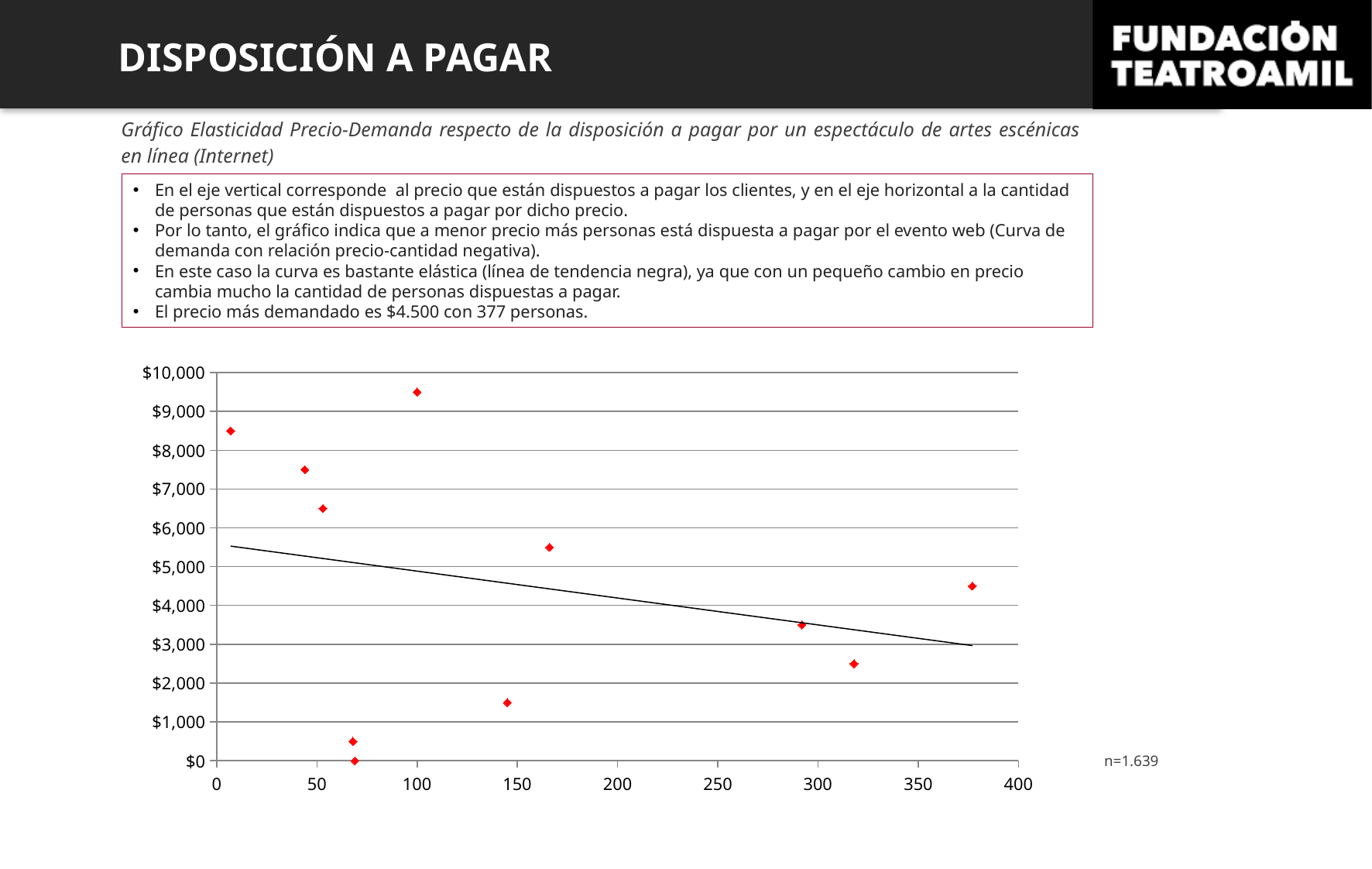
Which has the higher price: the leftmost point or the rightmost point? the leftmost point Is the price of the leftmost point greater or less than $8,000? greater Does the black trend line rise or fall as the quantity on the x axis increases? falls Is the price of the point near 145 people greater or less than $2,000? less What colour are the data point markers in the chart? red Is the price of the point near 318 people greater or less than $3,000? less What is the maximum value shown on the vertical (price) axis? $10,000 At what x-axis value (number of people) is the point with the highest price located? 100 How many data points are plotted in the scatter chart? 11 What kind of chart is shown on the slide? scatter chart